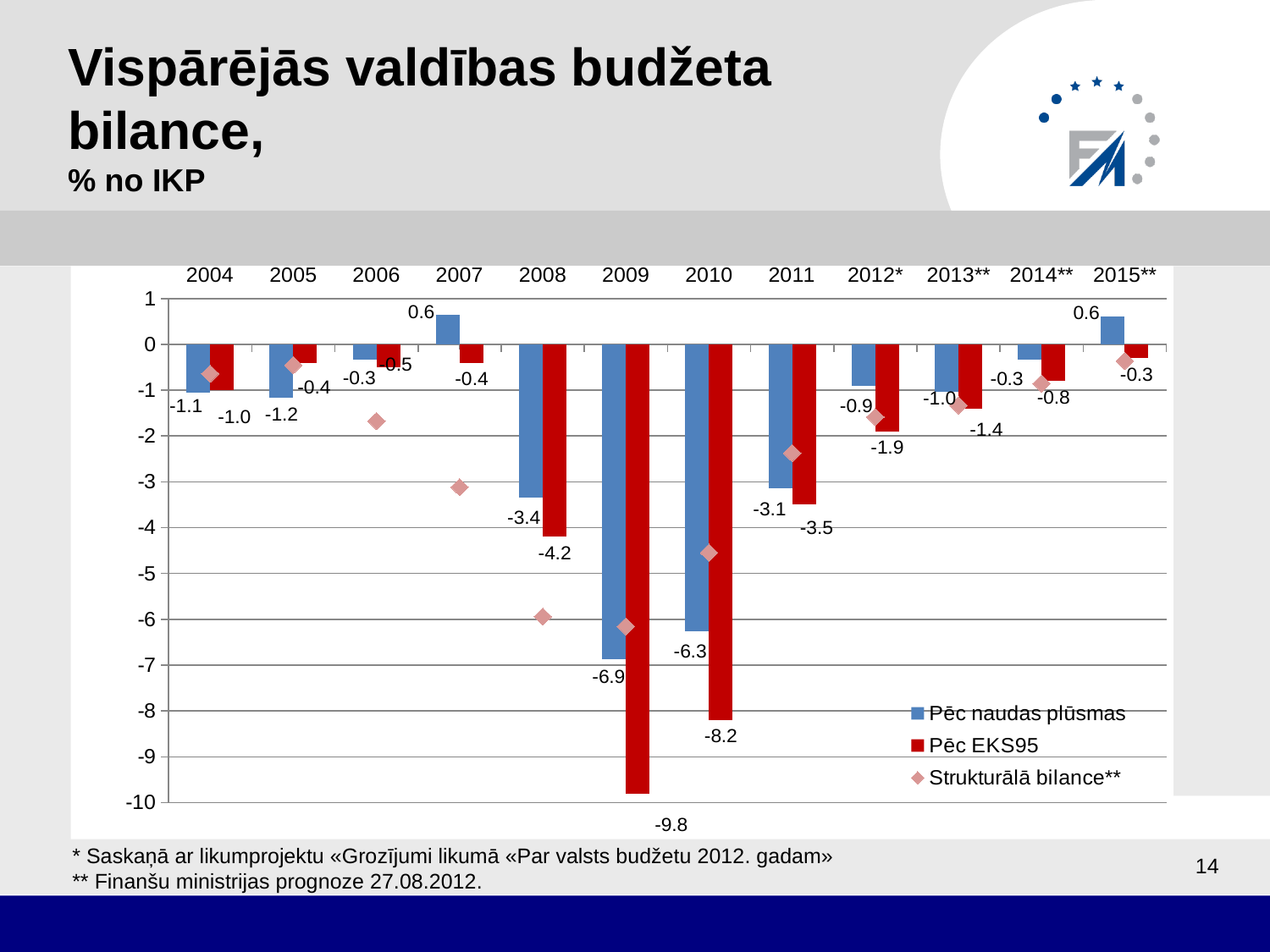
What is the value for Pēc EKS95 in 2012*? -1.9 Which is larger in 2011, the Pēc naudas plūsmas value or the Pēc EKS95 value? Pēc naudas plūsmas What is the value for Pēc EKS95 in 2009? -9.8 Which year has the lowest value for Pēc naudas plūsmas? 2009 Is the Strukturālā bilance** value for 2007 greater or less than -2? less What is the difference between the Pēc EKS95 value and the Pēc naudas plūsmas value in 2010? 1.9 What is the value for Pēc naudas plūsmas in 2010? -6.3 Is the Strukturālā bilance** value for 2009 greater or less than -5? less How many series does the legend list? 3 What kind of chart is used for the Pēc naudas plūsmas and Pēc EKS95 series? bar chart How many years are shown on the x axis? 12 Which year has the lowest value for Pēc EKS95? 2009